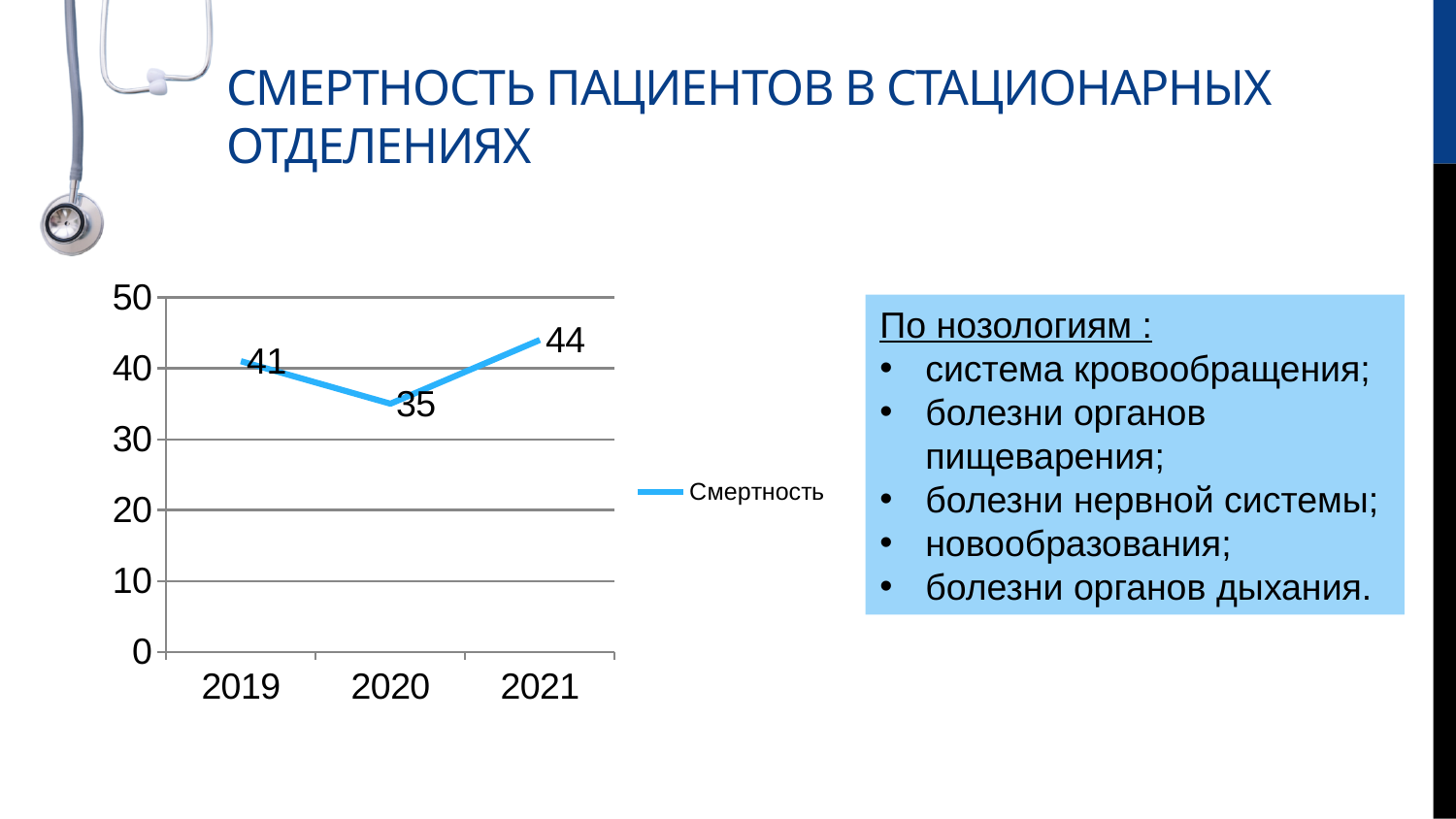
What series name does the legend show? Смертность What is the value for 2021? 44 What is the value for 2019? 41 Is the value for 2020 greater or less than 40? less Which year has the lowest value? 2020 What is the difference between the values for 2021 and 2020? 9 What is the value for 2020? 35 Which is larger, the value for 2019 or the value for 2021? 2021 What kind of chart is shown on the slide? line chart Which year has the highest value? 2021 What is the difference between the values for 2019 and 2020? 6 How many years are shown on the x axis? 3